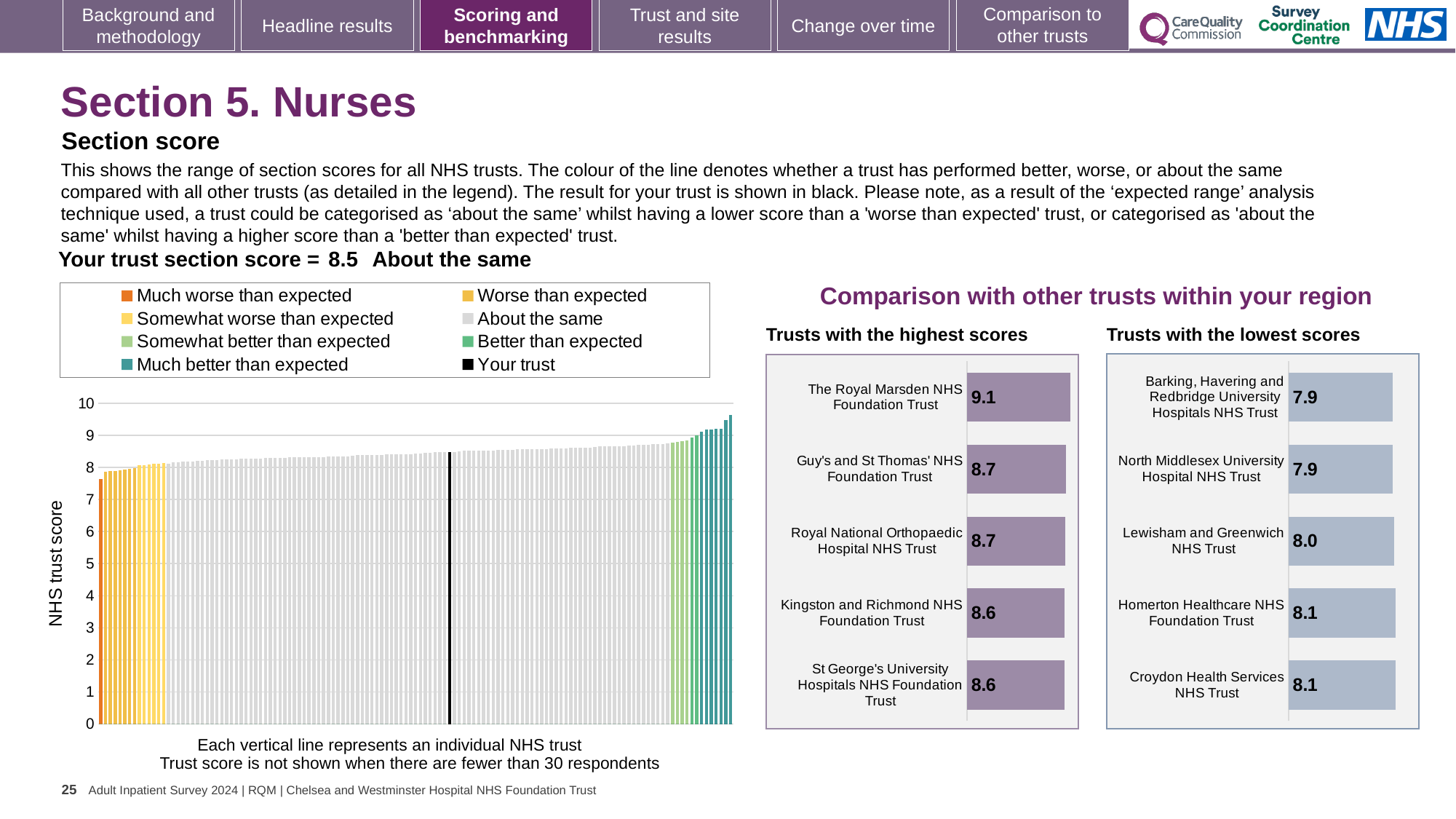
What kind of chart is the NHS trust score chart on the left? bar chart In the 'Trusts with the highest scores' chart, what is the score for The Royal Marsden NHS Foundation Trust? 9.1 How many trusts are shown in the 'Trusts with the lowest scores' chart? 5 In the 'Trusts with the highest scores' chart, which trust has the highest score? The Royal Marsden NHS Foundation Trust In the 'Trusts with the lowest scores' chart, what is the score for Lewisham and Greenwich NHS Trust? 8.0 How many entries does the legend of the NHS trust score chart on the left list? 8 Comparing the two small charts on the right, which has the higher score: Kingston and Richmond NHS Foundation Trust or Lewisham and Greenwich NHS Trust? Kingston and Richmond NHS Foundation Trust How many trusts are shown in the 'Trusts with the highest scores' chart? 5 In the NHS trust score chart on the left, is the value for your trust (the black line) greater or less than 8? greater In the 'Trusts with the highest scores' chart, what is the difference between the scores of The Royal Marsden NHS Foundation Trust and Guy's and St Thomas' NHS Foundation Trust? 0.4 In the 'Trusts with the lowest scores' chart, what is the difference between the scores of Croydon Health Services NHS Trust and North Middlesex University Hospital NHS Trust? 0.2 What is the title of the comparison section on the right of the slide? Comparison with other trusts within your region